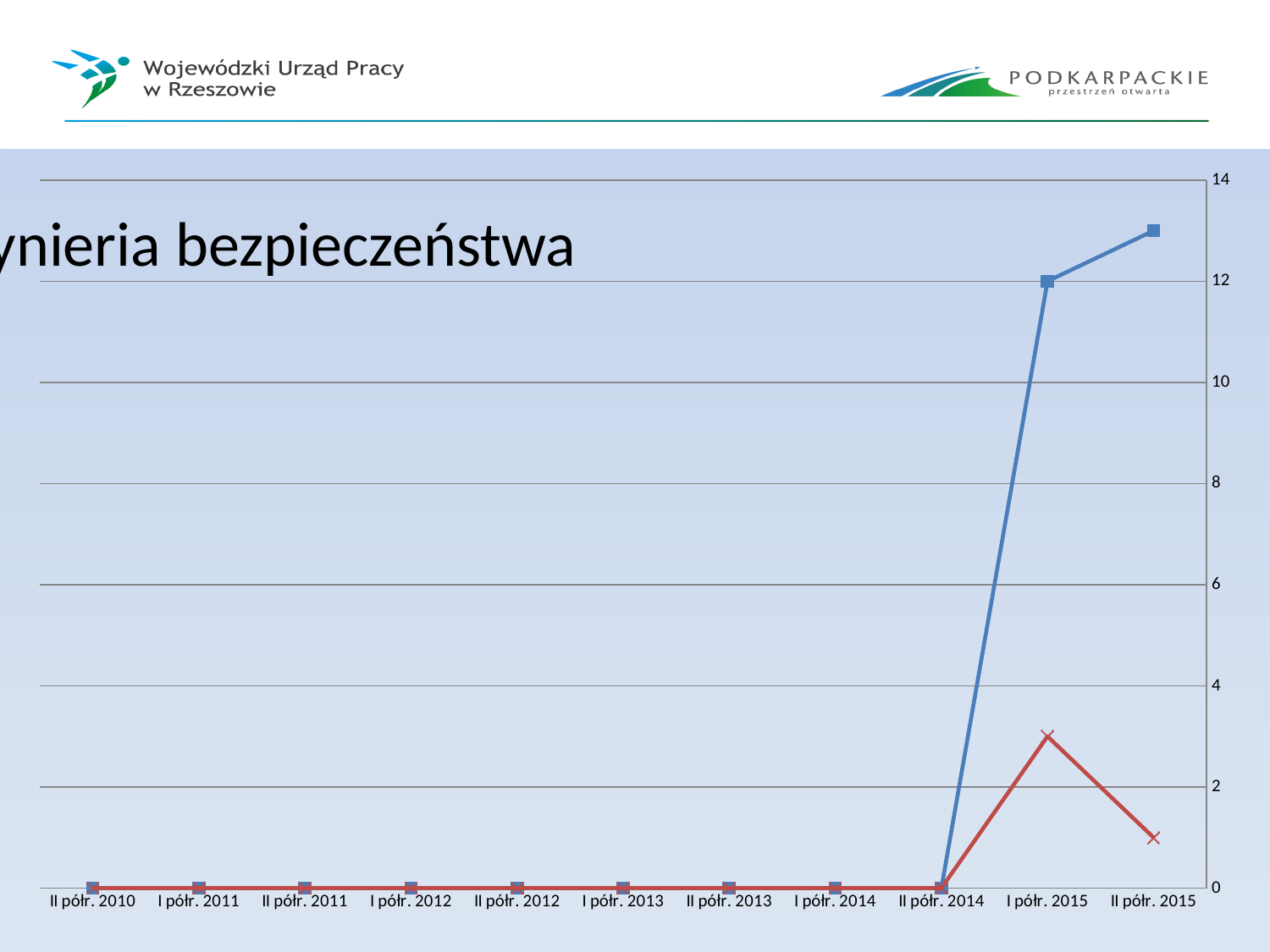
What is the value of the blue line at II półr. 2014? 0 What kind of chart is shown on the slide? line chart How many lines are plotted on the chart? 2 At which category does the blue line reach its highest value? II półr. 2015 Is the value of the red line at I półr. 2015 greater or less than 2? greater Is the value of the blue line at II półr. 2015 greater or less than 12? greater What is the value of the blue line at I półr. 2015? 12 How many categories are shown on the x axis of the chart? 11 Is the value of the red line at II półr. 2015 greater or less than 2? less At II półr. 2015, which line has the larger value, the blue line or the red line? the blue line At which category does the red line reach its highest value? I półr. 2015 What is the value of the red line at I półr. 2014? 0